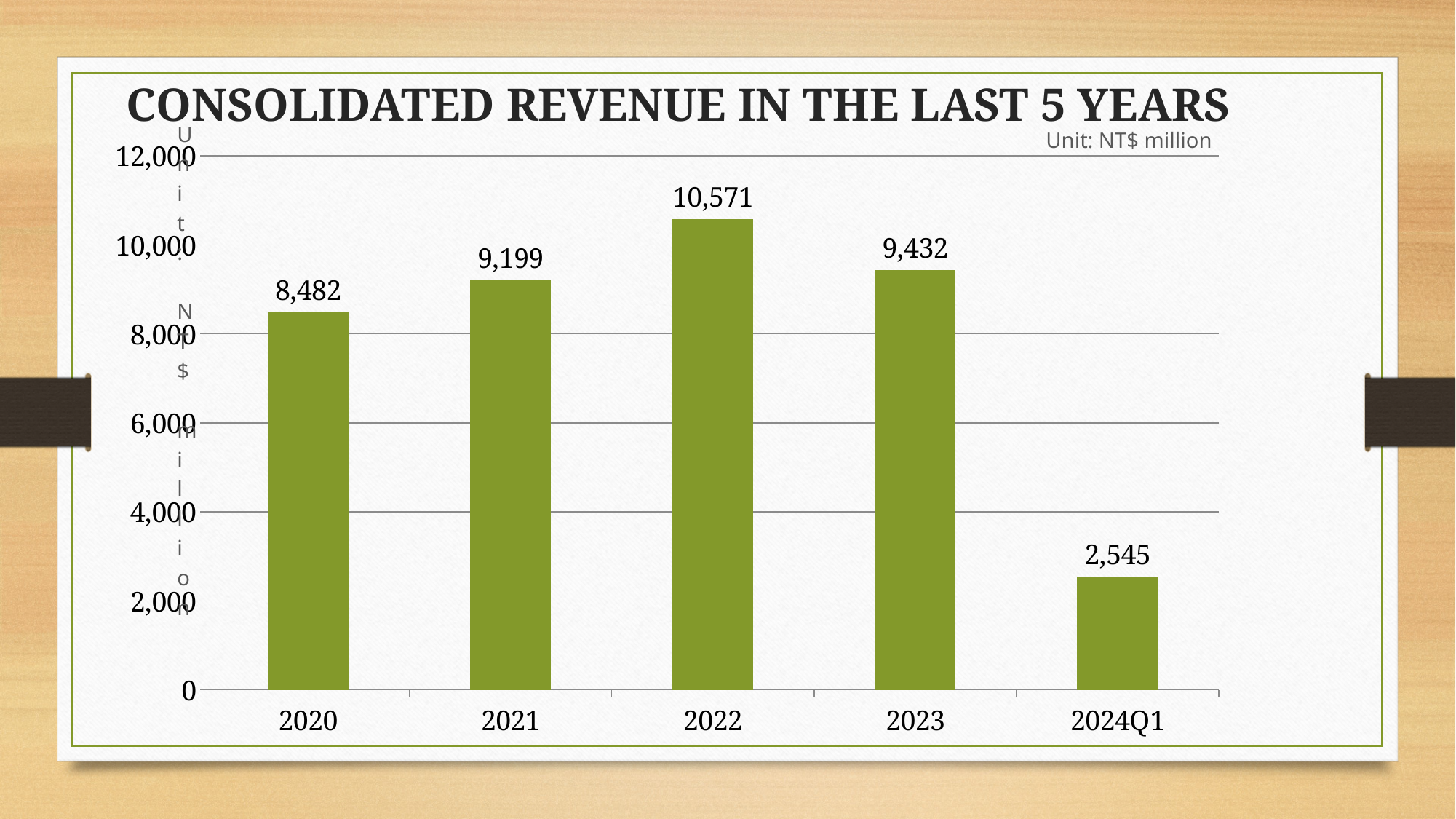
What is the difference between the revenue in 2022 and 2023? 1,139 What kind of chart is shown on the slide? bar chart Which category has the lowest value on the chart? 2024Q1 Which year has the highest consolidated revenue? 2022 What is the value shown for 2024Q1? 2,545 Is the value for 2023 greater or less than 10,000? less What is the consolidated revenue for 2022? 10,571 How many categories are shown on the x axis? 5 What is the difference between the revenue in 2021 and 2020? 717 What is the consolidated revenue for 2020? 8,482 What unit is stated for the values on the chart? NT$ million Which is larger, the revenue for 2021 or for 2023? 2023